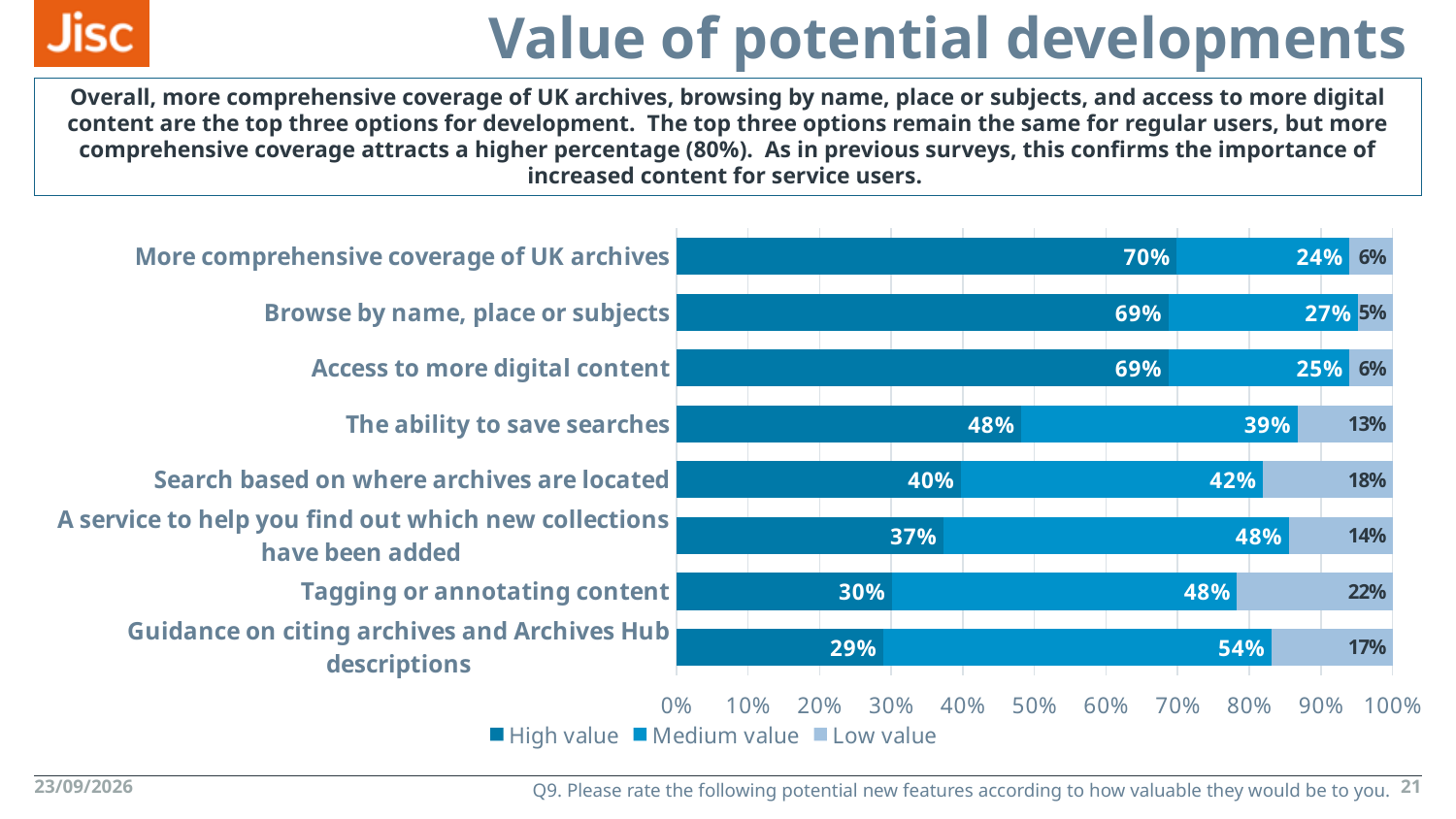
How many potential developments (categories) are plotted in the chart? 8 Which has a larger Low value percentage: 'Search based on where archives are located' or 'The ability to save searches'? Search based on where archives are located Which category has the highest High value percentage? More comprehensive coverage of UK archives What is the difference between the High value percentages for 'The ability to save searches' and 'Search based on where archives are located'? 8% How many series does the legend list? 3 Which series is shown in the lightest blue colour in the legend? Low value What is the Medium value percentage for 'Guidance on citing archives and Archives Hub descriptions'? 54% What is the Low value percentage for 'Tagging or annotating content'? 22% What is the High value percentage for 'More comprehensive coverage of UK archives'? 70% What kind of chart is shown on the slide? Stacked bar chart Which category has the lowest High value percentage? Guidance on citing archives and Archives Hub descriptions What is the total of the stacked bar for 'Access to more digital content'? 100%